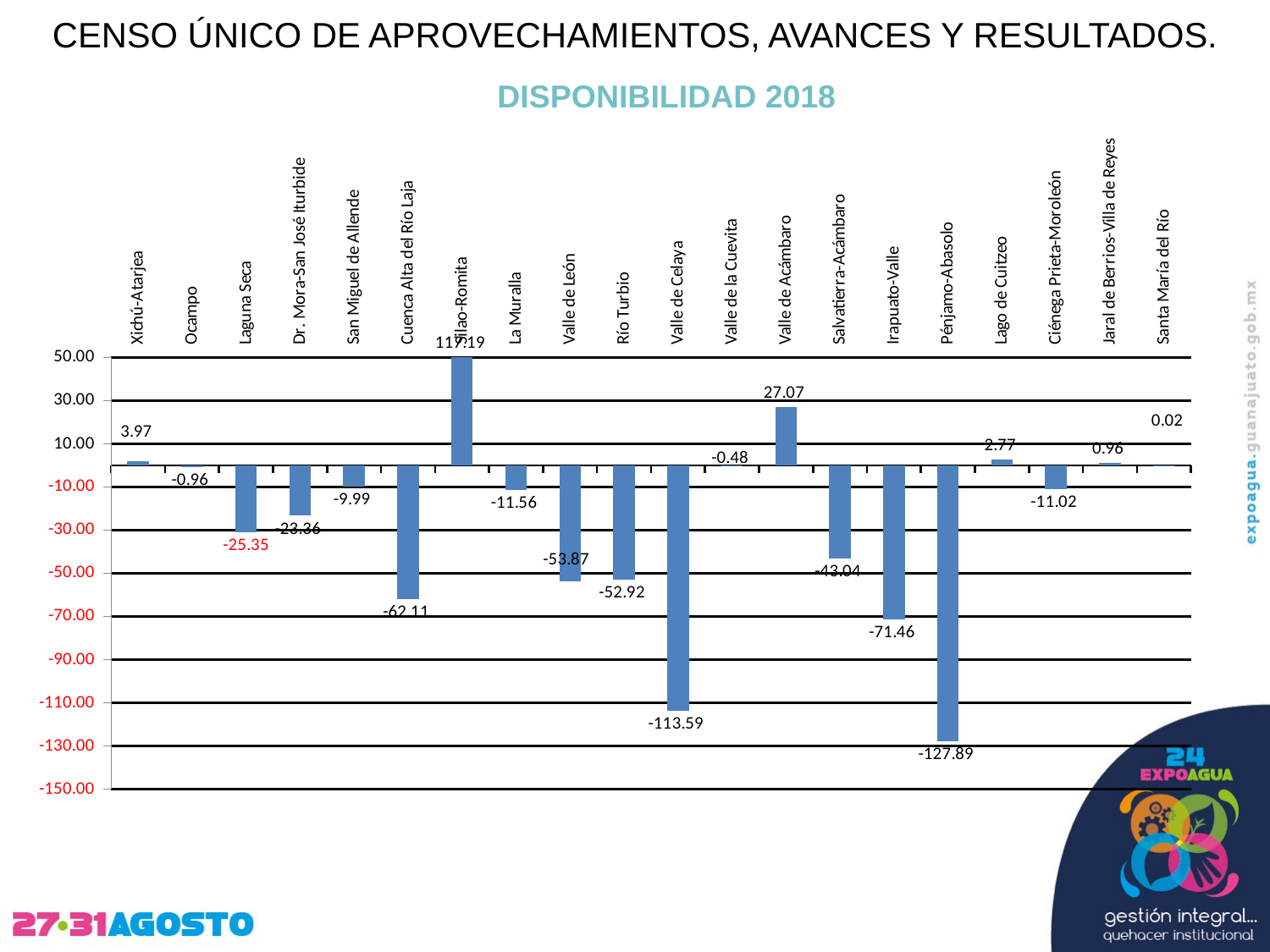
What is the difference between the values for Pénjamo-Abasolo and Valle de Celaya? 14.30 Which is larger, the value for Valle de Acámbaro or the value for Xichú-Atarjea? Valle de Acámbaro Which category has the highest value? Silao-Romita What is the value for Cuenca Alta del Río Laja? -62.11 What is the value for Valle de Celaya? -113.59 What is the value for Laguna Seca? -25.35 Which category has the lowest value? Pénjamo-Abasolo What is the title of the chart? DISPONIBILIDAD 2018 What kind of chart is shown on the slide? bar chart Is the value for Cuenca Alta del Río Laja greater or less than -50.00? less What is the value for Valle de Acámbaro? 27.07 How many categories are shown on the x axis? 20